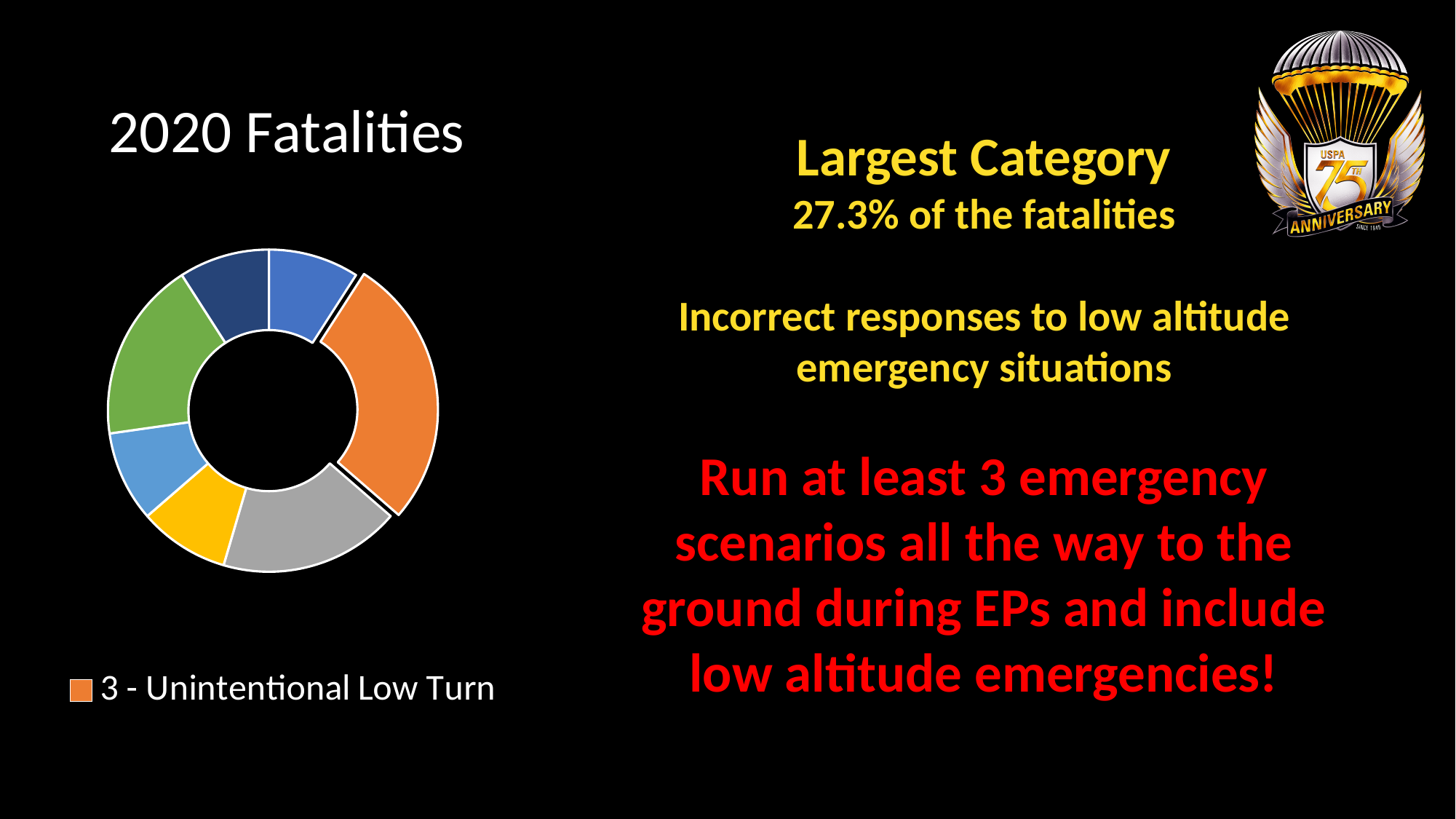
How many slices does the 2020 Fatalities doughnut chart have? 7 In the 2020 Fatalities chart, is the green slice larger or smaller than the orange slice? Smaller What is the title of the chart on the slide? 2020 Fatalities In the 2020 Fatalities chart, is the orange slice larger or smaller than the yellow slice? Larger What share of the 2020 fatalities does the largest category account for? 27.3% What colour is the slice for 3 - Unintentional Low Turn in the 2020 Fatalities chart? Orange In the 2020 Fatalities chart, is the gray slice larger or smaller than the yellow slice? Larger How many entries does the legend of the 2020 Fatalities chart list? 1 Which category is the largest slice in the 2020 Fatalities chart? 3 - Unintentional Low Turn What kind of chart is shown on the slide? Doughnut (pie) chart